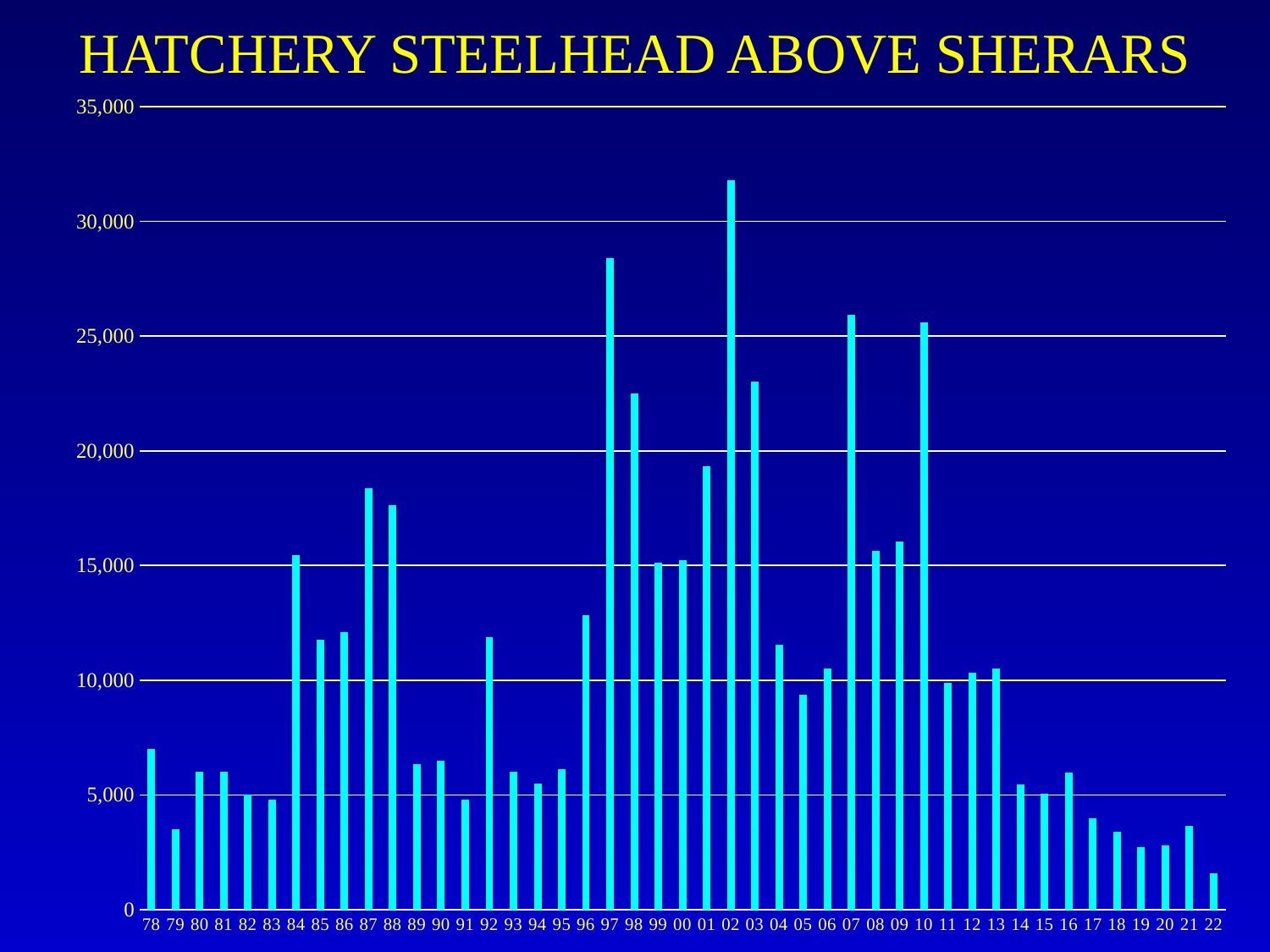
What kind of chart is shown on the slide? bar chart Do the values rise or fall from 13 to 15? fall Which year has the larger value, 97 or 98? 97 Is the value for 05 greater or less than 10,000? less Which year has the highest value? 02 Is the value for 84 greater or less than 15,000? greater How many years (bars) are plotted on the chart? 45 What is the title of the chart? HATCHERY STEELHEAD ABOVE SHERARS Is the value for 79 greater or less than 5,000? less Which year has the lowest value? 22 Which year has the larger value, 02 or 07? 02